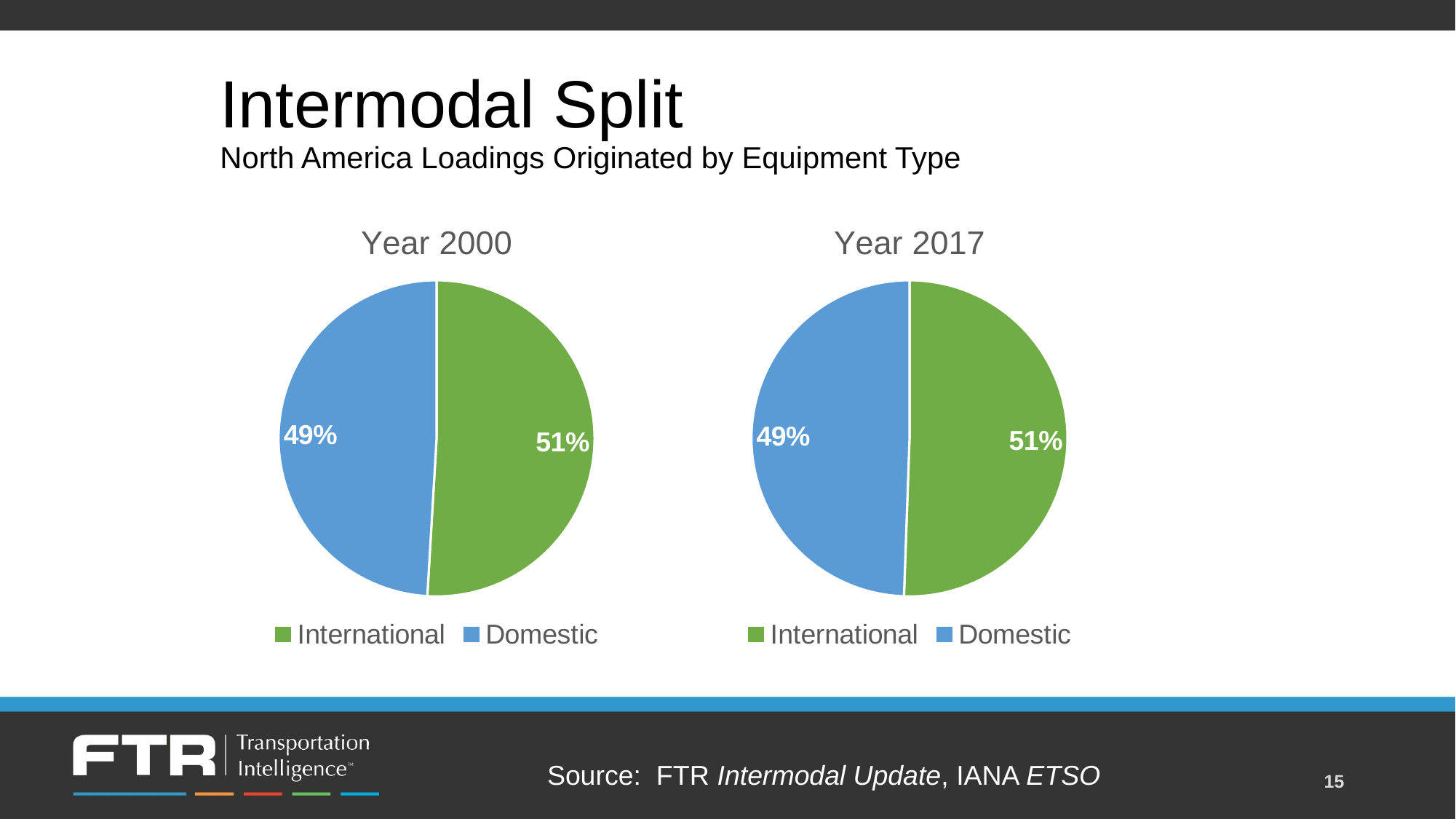
In the Year 2000 chart, what share of loadings is International? 51% In the Year 2017 chart, what is the difference in percentage points between International and Domestic? 2 In the Year 2000 chart, how many slices does the pie have? 2 In the Year 2017 chart, which category has the smaller share? Domestic In the Year 2017 chart, what share of loadings is International? 51% In the Year 2000 chart, which category has the larger share? International In the Year 2017 chart, what share of loadings is Domestic? 49% What kind of chart is the Year 2017 chart? Pie chart How many entries does the legend of the Year 2000 chart list? 2 In the Year 2000 chart, what share of loadings is Domestic? 49% In the Year 2017 chart, what colour represents Domestic? Blue What is the title of the chart on the left? Year 2000